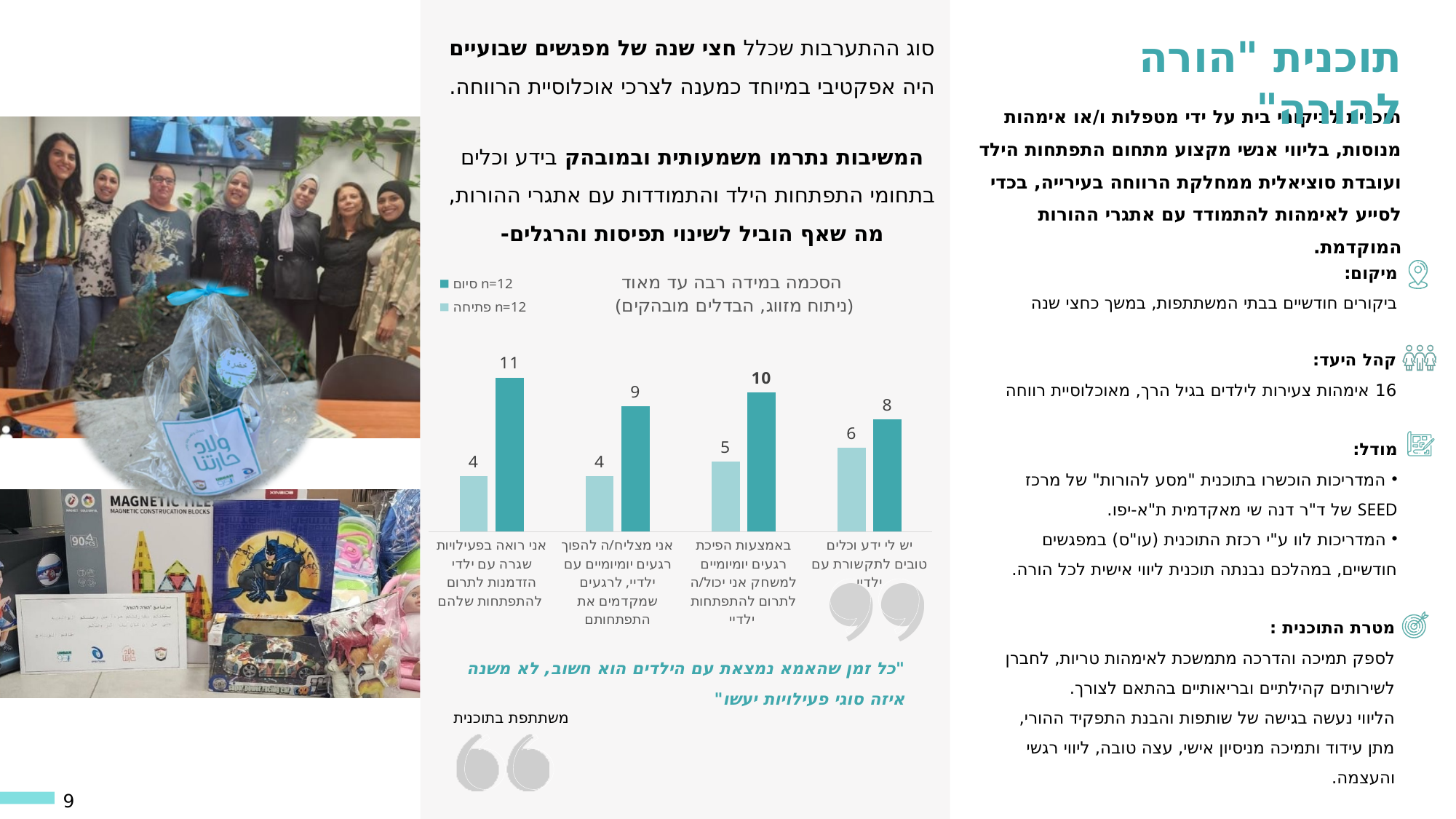
How many series does the chart legend list? 2 How many categories are shown on the chart's x axis? 4 What is the value of the 'פתיחה n=12' series for the category 'יש לי ידע וכלים טובים לתקשורת עם ילדיי'? 6 For the category 'יש לי ידע וכלים טובים לתקשורת עם ילדיי', which series has the larger value, 'סיום n=12' or 'פתיחה n=12'? סיום n=12 Which legend entry is shown in the lighter teal colour? פתיחה n=12 What kind of chart is shown on the slide? bar chart What is the value of the 'סיום n=12' series for the category 'באמצעות הפיכת רגעים יומיומיים למשחק אני יכול/ה לתרום להתפתחות ילדיי'? 10 What is the value of the 'סיום n=12' series for the category 'אני רואה בפעילויות שגרה עם ילדי הזדמנות לתרום להתפתחות שלהם'? 11 Which category has the lowest 'סיום n=12' value? יש לי ידע וכלים טובים לתקשורת עם ילדיי What is the title of the chart? הסכמה במידה רבה עד מאוד (ניתוח מזווג, הבדלים מובהקים) What is the difference between the 'סיום n=12' and 'פתיחה n=12' values for the category 'אני מצליח/ה להפוך רגעים יומיומיים עם ילדיי, לרגעים שמקדמים את התפתחותם'? 5 Which category has the highest 'סיום n=12' value? אני רואה בפעילויות שגרה עם ילדי הזדמנות לתרום להתפתחות שלהם